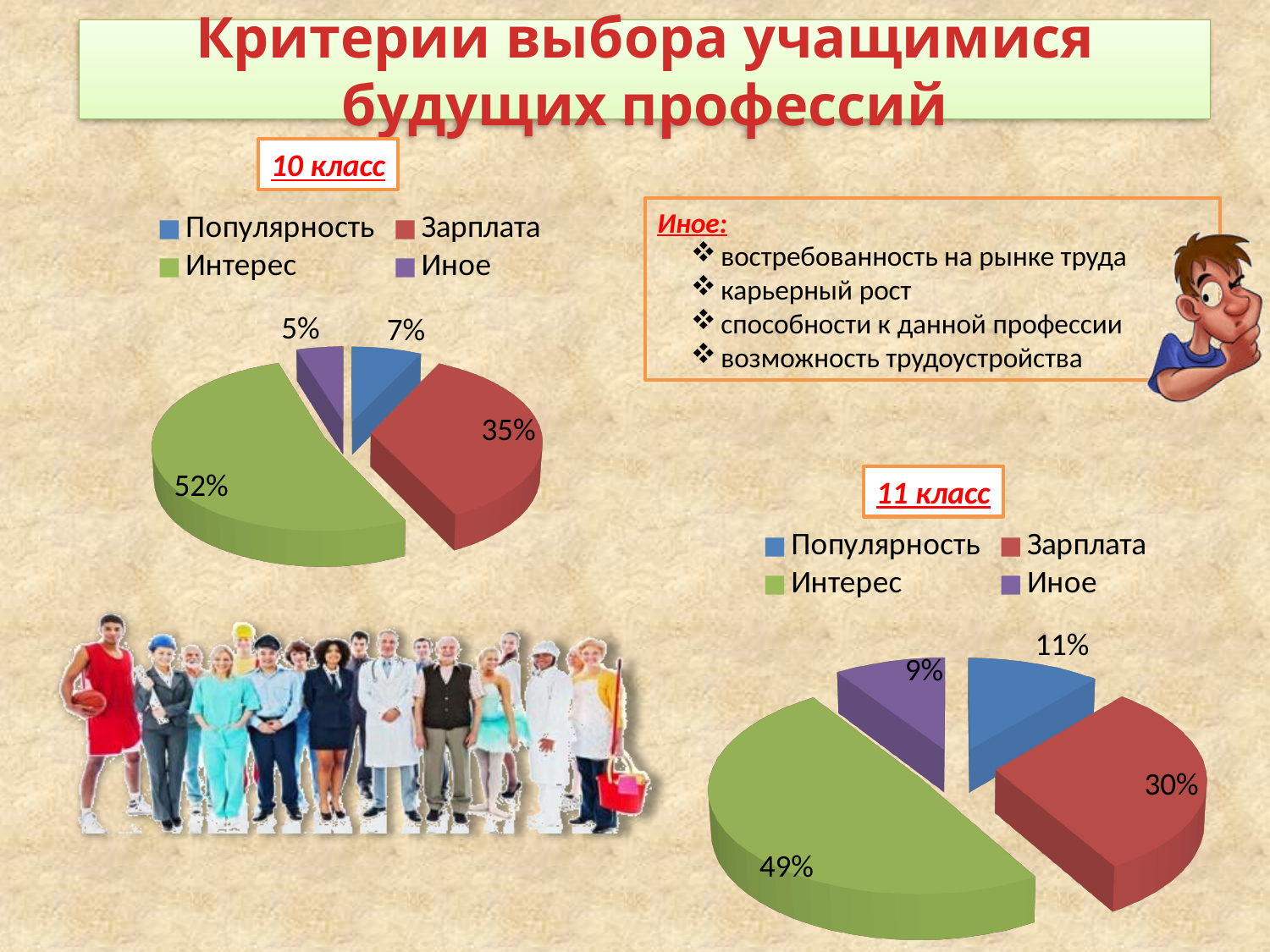
In the "11 класс" pie chart, what share does Иное have? 9% What type of chart is used for "10 класс"? Pie chart In the "10 класс" pie chart, which category has the largest share? Интерес In the "10 класс" pie chart, what share does Зарплата have? 35% In the "10 класс" pie chart, what share does Интерес have? 52% In the "11 класс" pie chart, which category has the smallest share? Иное In the "11 класс" pie chart, what share does Популярность have? 11% Which is larger: the share of Популярность in the "10 класс" chart or in the "11 класс" chart? 11 класс In the "11 класс" pie chart, what is the difference between the shares of Интерес and Зарплата? 19% How many categories does the "11 класс" pie chart show? 4 In the "10 класс" pie chart, what is the difference between the shares of Зарплата and Популярность? 28% In the "10 класс" pie chart, which category has the smallest share? Иное